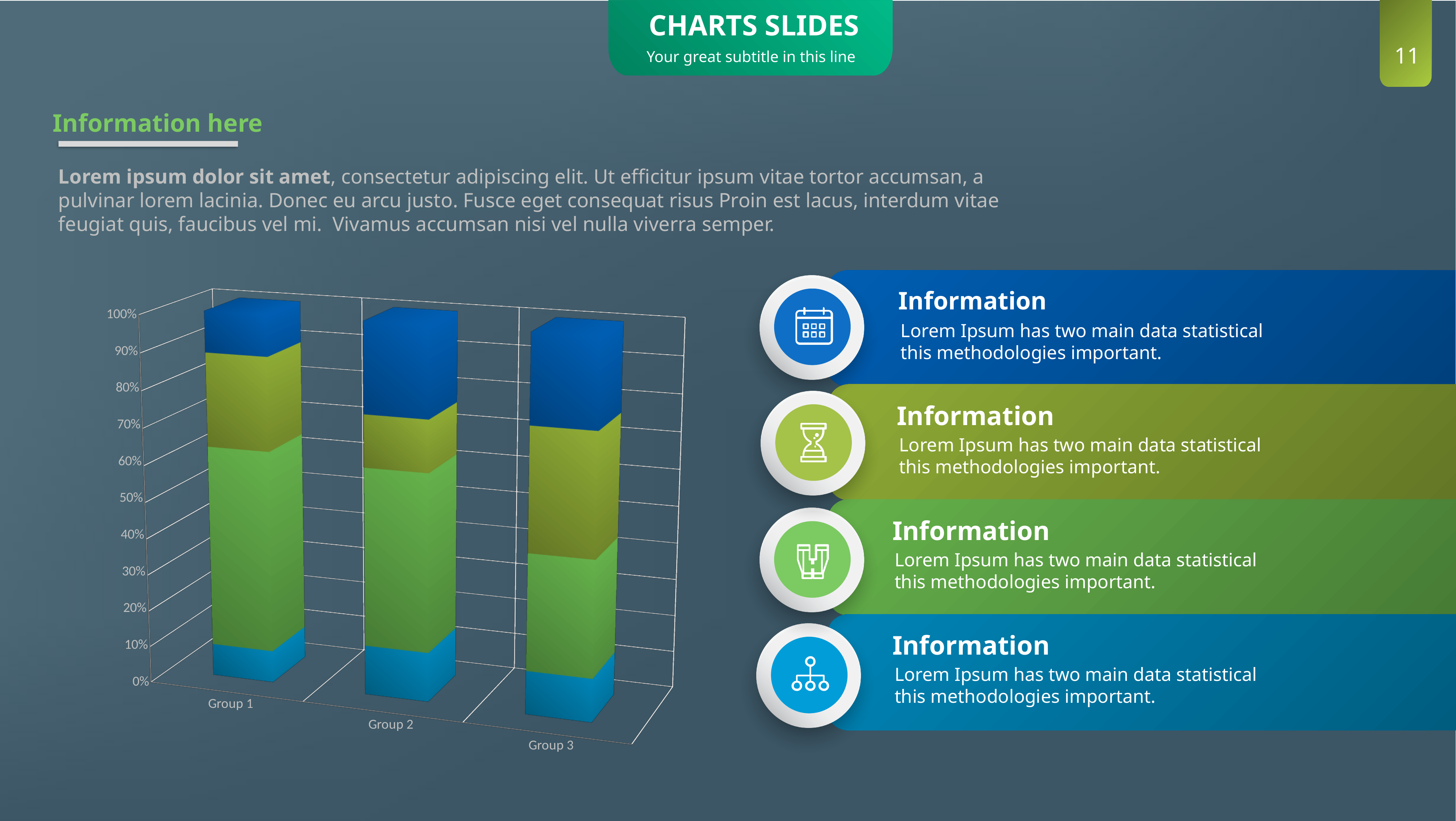
Is the olive (yellow-green) segment larger in Group 2 or in Group 3? Group 3 What is the label of the third category on the x axis of the chart? Group 3 Which group has the smallest green segment in the chart? Group 3 How many groups (categories) are shown on the x axis of the chart? 3 What kind of chart is shown on the slide? Stacked bar chart Is the top of the green segment in Group 1 greater or less than 50%? greater Is the dark blue (top) segment larger in Group 1 or in Group 3? Group 3 What is the highest value labelled on the vertical axis of the chart? 100% Is the top of the green segment in Group 3 greater or less than 50%? less How many coloured segments does each bar in the chart contain? 4 Is the green segment larger in Group 1 or in Group 3? Group 1